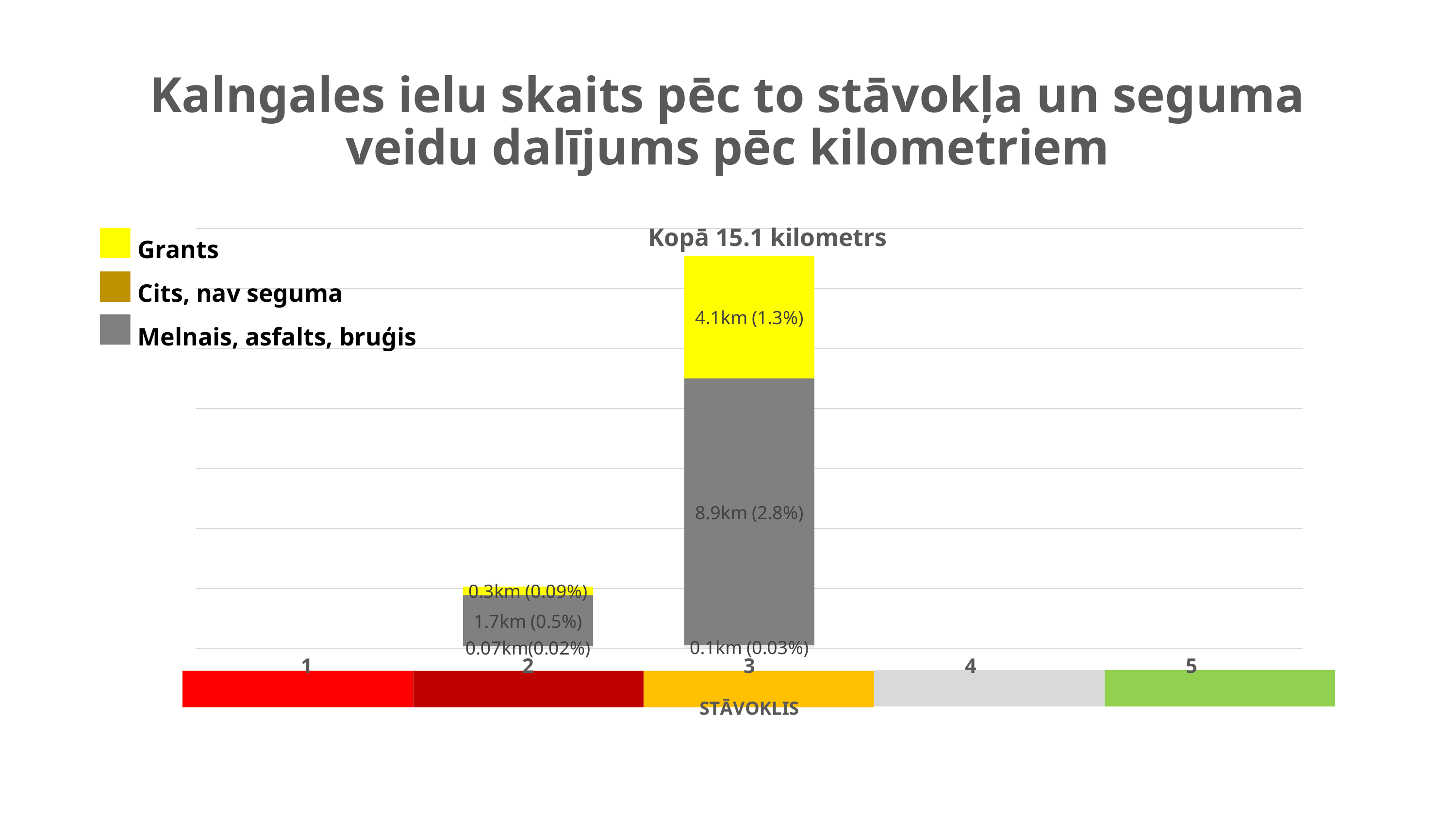
What is the value of the Grants (yellow) segment for category 3? 4.1km (1.3%) What is the value of the Grants (yellow) segment for category 2? 0.3km (0.09%) Which is larger: the Grants segment for category 3 or the Grants segment for category 2? category 3 Which category has the tallest stacked bar? 3 What kind of chart is shown on the slide? stacked bar chart What is the difference in kilometres between the grey segment for category 3 (8.9km) and the grey segment for category 2 (1.7km)? 7.2km What total length is stated above the chart? Kopā 15.1 kilometrs How many series does the legend list? 3 What is the value of the Melnais, asfalts, bruģis (grey) segment for category 2? 1.7km (0.5%) How many categories are shown on the x axis (STĀVOKLIS)? 5 What is the value of the Cits, nav seguma segment for category 3? 0.1km (0.03%) What is the value of the Melnais, asfalts, bruģis (grey) segment for category 3? 8.9km (2.8%)